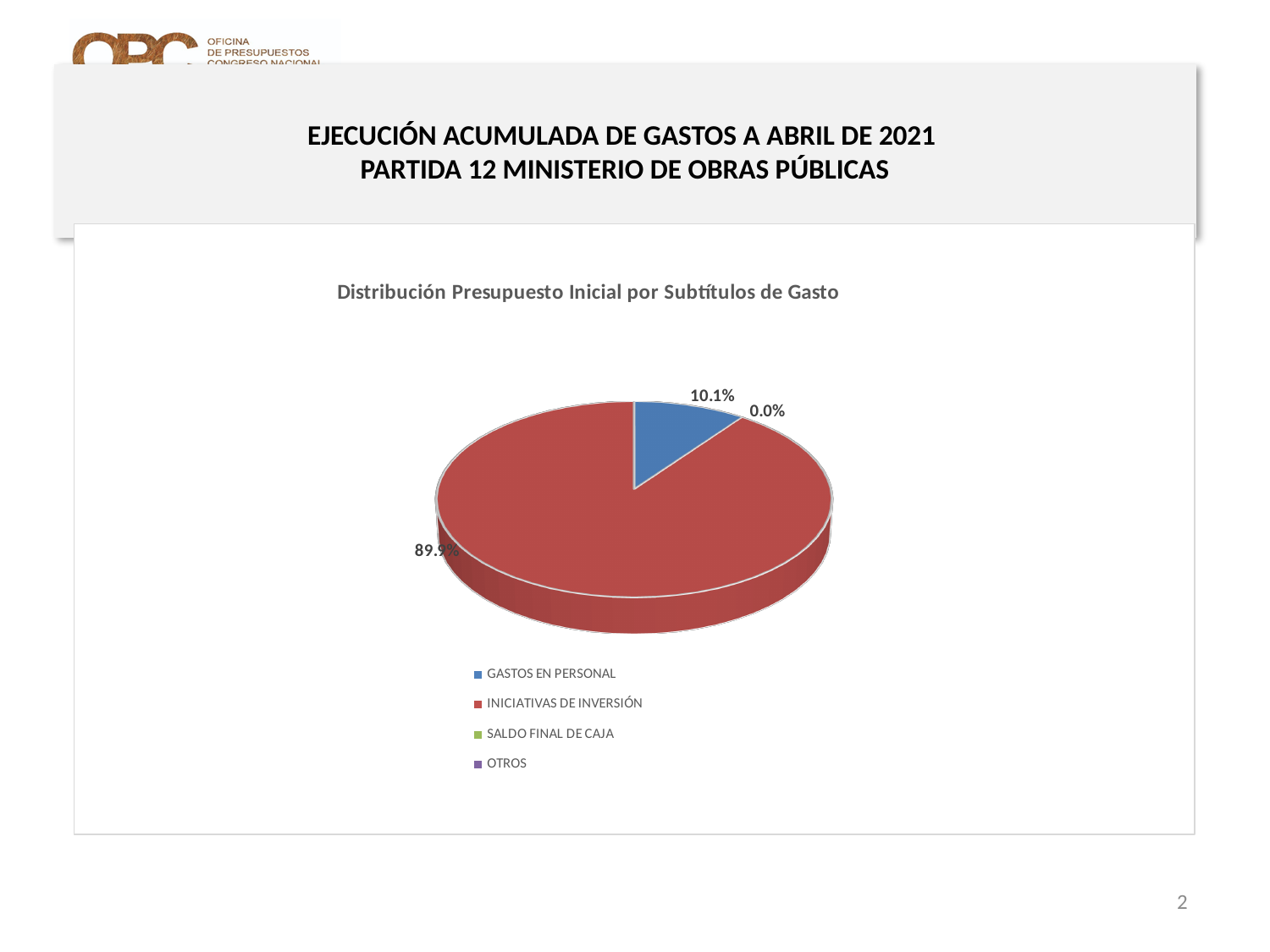
What do the GASTOS EN PERSONAL and INICIATIVAS DE INVERSIÓN shares add up to? 100.0% Which has the larger share, GASTOS EN PERSONAL or INICIATIVAS DE INVERSIÓN? INICIATIVAS DE INVERSIÓN What share of the pie does INICIATIVAS DE INVERSIÓN represent? 89.9% How many categories does the legend list? 4 What is the title of the chart? Distribución Presupuesto Inicial por Subtítulos de Gasto What colour is the INICIATIVAS DE INVERSIÓN slice? Red Which category has the largest slice of the pie? INICIATIVAS DE INVERSIÓN What share of the pie does GASTOS EN PERSONAL represent? 10.1% Which has the smaller share, GASTOS EN PERSONAL or INICIATIVAS DE INVERSIÓN? GASTOS EN PERSONAL What kind of chart is shown on the slide? Pie chart Is the share for INICIATIVAS DE INVERSIÓN greater or less than 50%? greater What is the difference in percentage points between the INICIATIVAS DE INVERSIÓN share and the GASTOS EN PERSONAL share? 79.8 percentage points